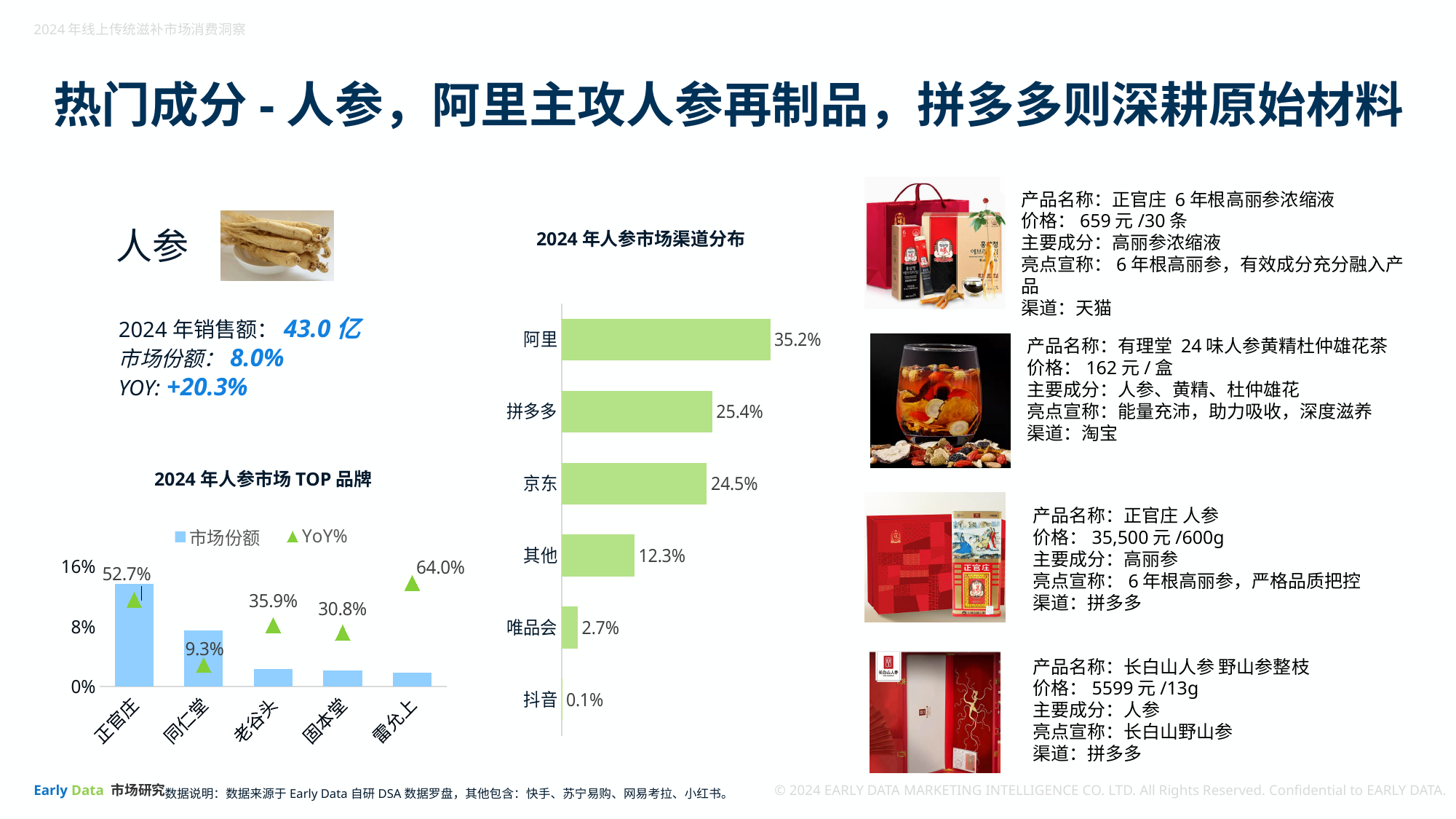
In the chart titled 2024年人参市场渠道分布, what is the value for 京东? 24.5% In the chart titled 2024年人参市场TOP品牌, how many series does the legend list? 2 In the chart titled 2024年人参市场渠道分布, which channel has the lowest value? 抖音 In the chart titled 2024年人参市场渠道分布, what is the value for 阿里? 35.2% What kind of chart is the one titled 2024年人参市场渠道分布? Bar chart In the chart titled 2024年人参市场TOP品牌, which brand has the lowest YoY%? 同仁堂 In the chart titled 2024年人参市场TOP品牌, what is the YoY% value for 雷允上? 64.0% In the chart titled 2024年人参市场TOP品牌, is the 市场份额 value for 正官庄 greater or less than 8%? greater In the chart titled 2024年人参市场渠道分布, what is the difference between the values for 阿里 and 拼多多? 9.8% In the chart titled 2024年人参市场渠道分布, which channel has the highest value? 阿里 In the chart titled 2024年人参市场渠道分布, how many channels are shown? 6 In the chart titled 2024年人参市场TOP品牌, which brand has the larger 市场份额, 正官庄 or 老谷头? 正官庄